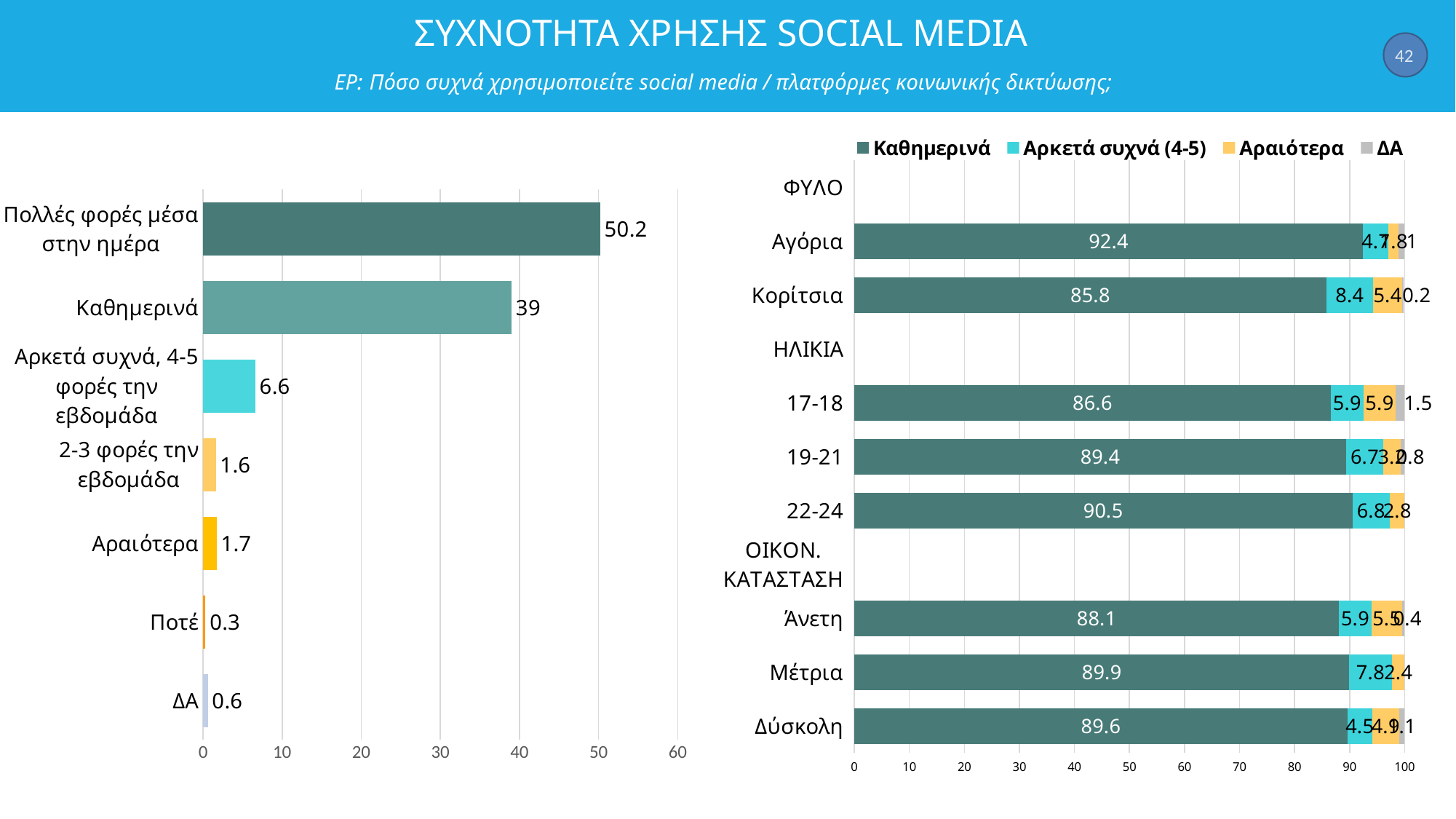
In the left chart, what is the difference between Πολλές φορές μέσα στην ημέρα and Καθημερινά? 11.2 In the left chart, which category has the lowest value? Ποτέ In the right chart, what is the Καθημερινά value for Αγόρια? 92.4 How many categories does the left chart show? 7 In the left chart, what is the value for Καθημερινά? 39 How many series does the legend of the right chart list? 4 In the left chart, what is the value for Πολλές φορές μέσα στην ημέρα? 50.2 In the left chart, which is larger: Αραιότερα or 2-3 φορές την εβδομάδα? Αραιότερα In the right chart, which group has the lowest Καθημερινά value? Κορίτσια In the right chart, what is the difference in Καθημερινά between Αγόρια and Κορίτσια? 6.6 What kind of chart is the left chart? bar chart In the right chart, what is the Αρκετά συχνά (4-5) value for Κορίτσια? 8.4